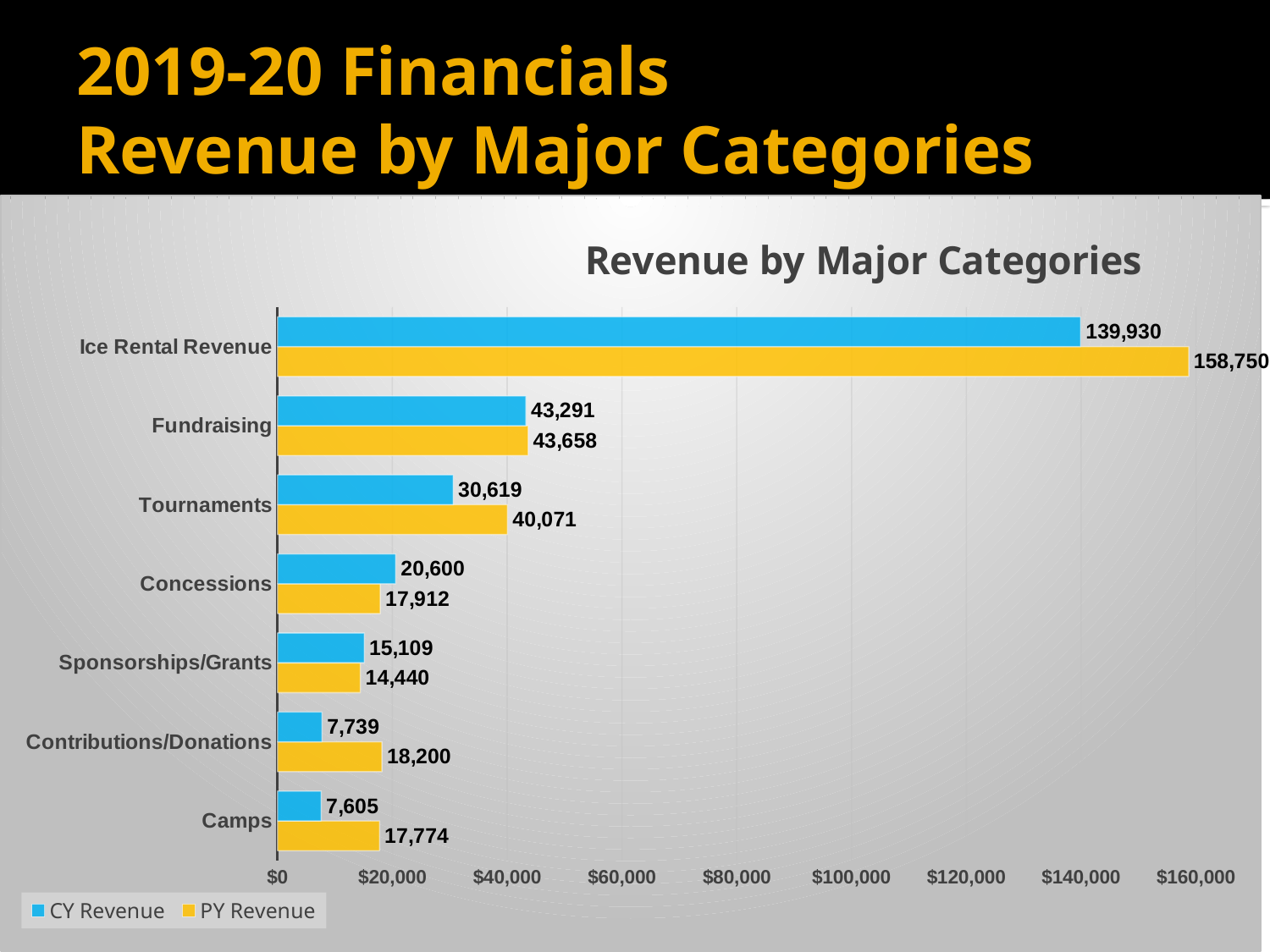
What is the PY Revenue for Contributions/Donations? 18,200 Which category has the highest PY Revenue? Ice Rental Revenue Which category has the lowest CY Revenue? Camps What is the difference between PY Revenue and CY Revenue for Ice Rental Revenue? 18,820 What is the PY Revenue for Tournaments? 40,071 How many categories are shown on the chart? 7 What is the CY Revenue for Ice Rental Revenue? 139,930 How many series does the legend list? 2 What is the difference between CY Revenue and PY Revenue for Concessions? 2,688 Which is larger for Sponsorships/Grants, CY Revenue or PY Revenue? CY Revenue Which is larger for Camps, CY Revenue or PY Revenue? PY Revenue What kind of chart is shown on the slide? Bar chart